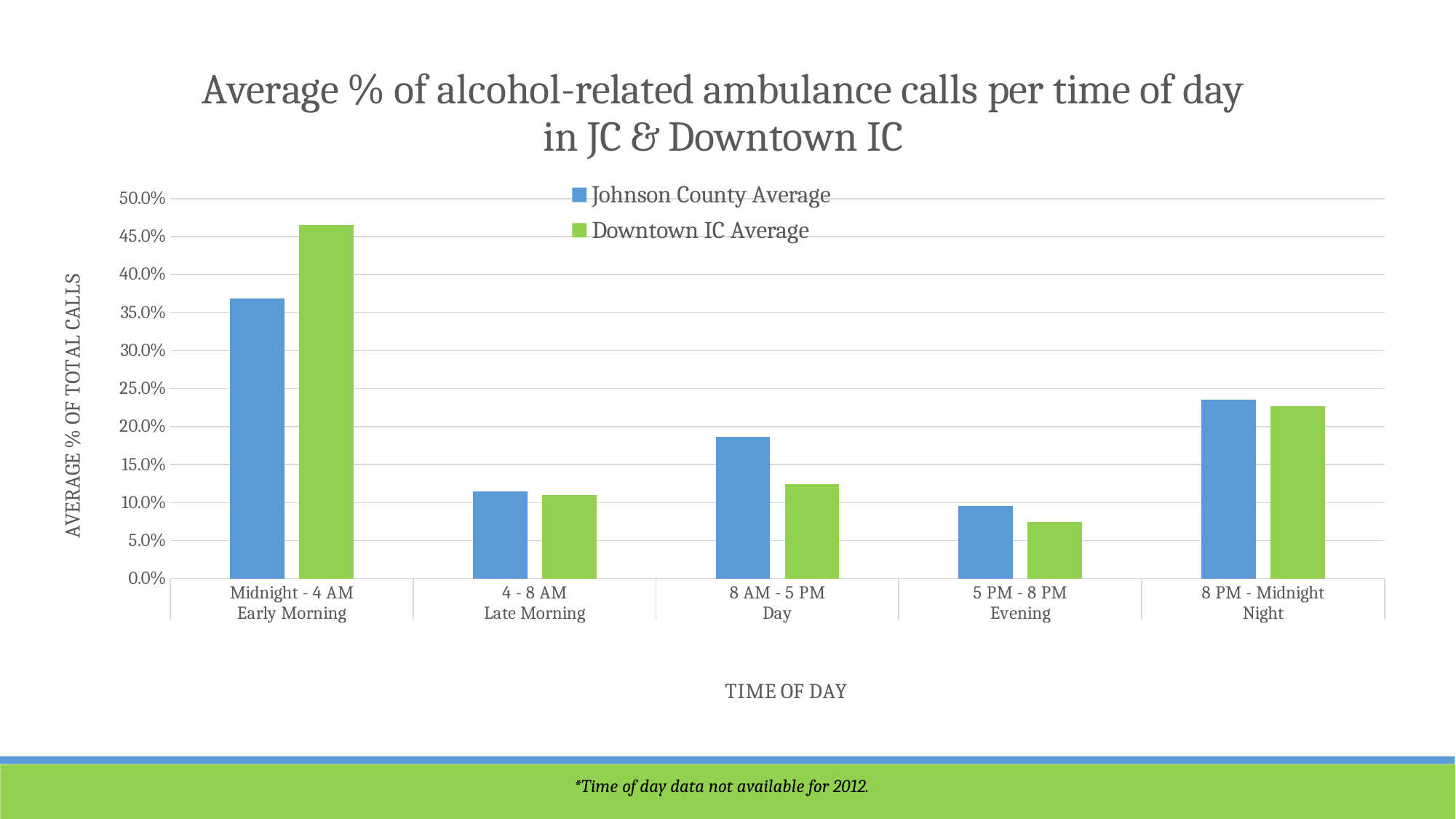
Which time of day has the lowest Downtown IC Average? 5 PM - 8 PM Evening For Midnight - 4 AM, which is larger: the Johnson County Average or the Downtown IC Average? Downtown IC Average Which time of day has the highest Downtown IC Average? Midnight - 4 AM Early Morning Which time of day has the lowest Johnson County Average? 5 PM - 8 PM Evening Which time of day has the highest Johnson County Average? Midnight - 4 AM Early Morning Is the Downtown IC Average for Midnight - 4 AM greater or less than 40.0%? greater Which series is shown in green in the legend? Downtown IC Average For 8 AM - 5 PM, which is larger: the Johnson County Average or the Downtown IC Average? Johnson County Average Is the Downtown IC Average for 5 PM - 8 PM greater or less than 10.0%? less How many series does the legend list? 2 What kind of chart is shown on the slide? bar chart How many time-of-day categories are shown on the x axis? 5